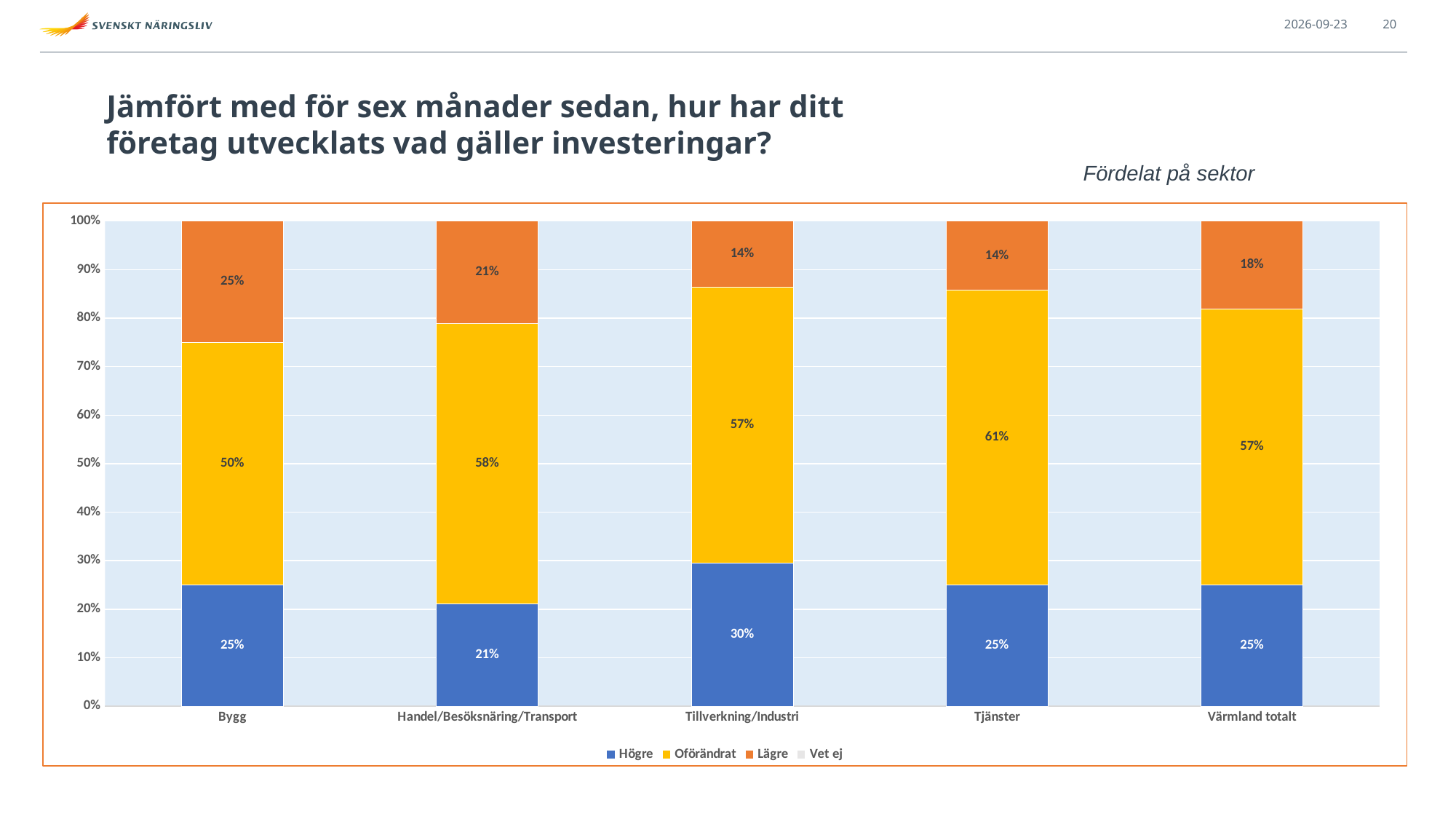
Which is larger: the Oförändrat value for Handel/Besöksnäring/Transport or the Oförändrat value for Bygg? Handel/Besöksnäring/Transport What is the Högre value for Tillverkning/Industri? 30% How many sectors (categories) are shown on the x axis? 5 Which sector has the lowest Högre value? Handel/Besöksnäring/Transport How many series does the legend list? 4 Which legend entry is shown in orange? Lägre What is the Lägre value for Bygg? 25% What is the Oförändrat value for Tjänster? 61% What is the Oförändrat value for Värmland totalt? 57% Which sector has the highest Högre value? Tillverkning/Industri What kind of chart is shown on the slide? Stacked bar chart What is the difference between the Lägre value for Bygg and the Lägre value for Tjänster? 11%